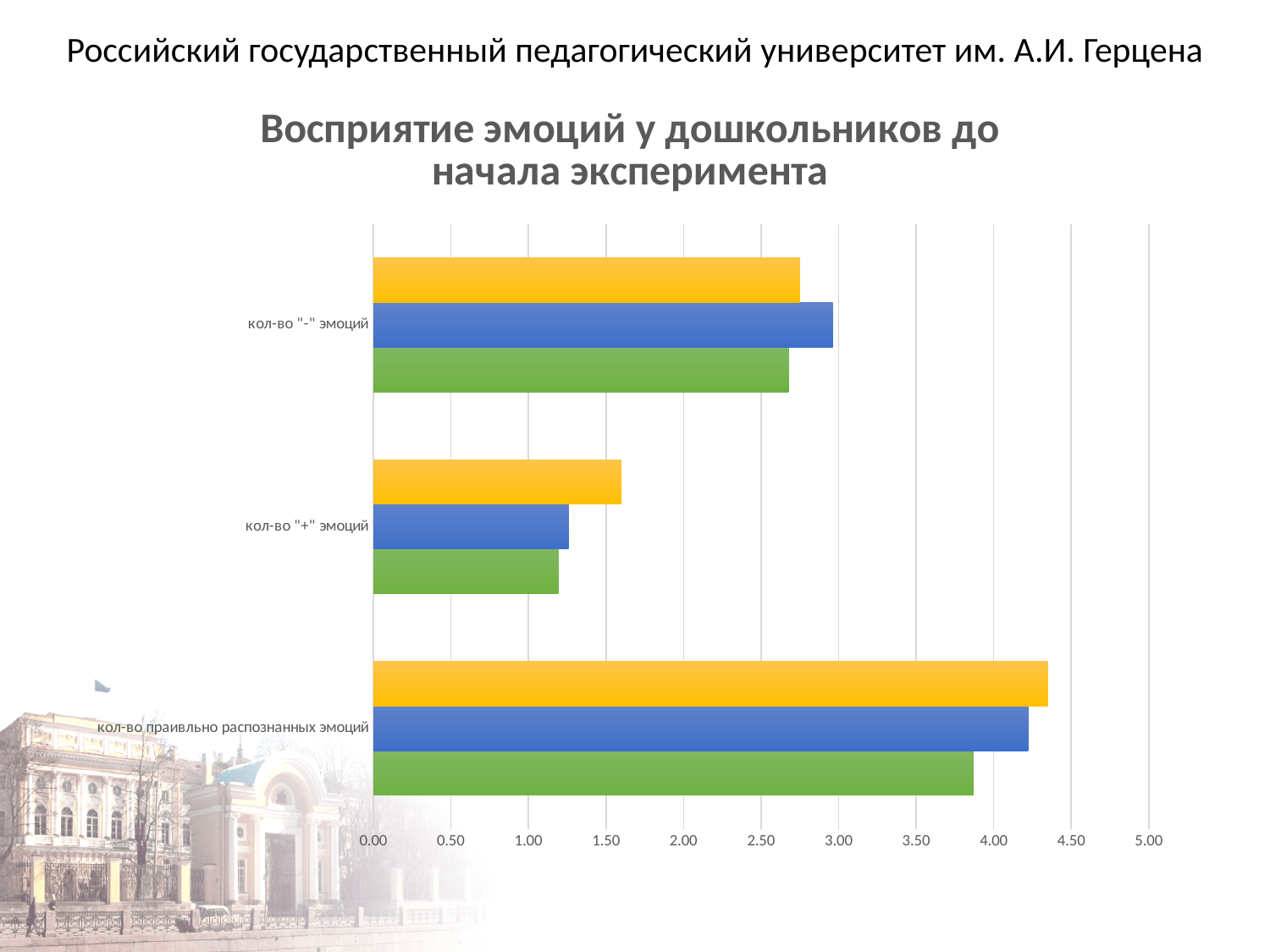
For "кол-во "+" эмоций", which bar is longer, the yellow one or the blue one? the yellow one What is the title of the chart? Восприятие эмоций у дошкольников до начала эксперимента Which category has the shortest bars in the chart? кол-во "+" эмоций Is the value of the green bar for "кол-во "-" эмоций" greater or less than 3.00? less Is the value of the green bar for "кол-во праивльно распознанных эмоций" greater or less than 4.00? less What is the highest value shown on the horizontal axis of the chart? 5.00 Is the value of the blue bar for "кол-во "+" эмоций" greater or less than 1.50? less Which category has the longest bars in the chart? кол-во праивльно распознанных эмоций What kind of chart is shown on the slide? bar chart How many bars are shown for each category in the chart? 3 How many categories are shown on the vertical axis of the chart? 3